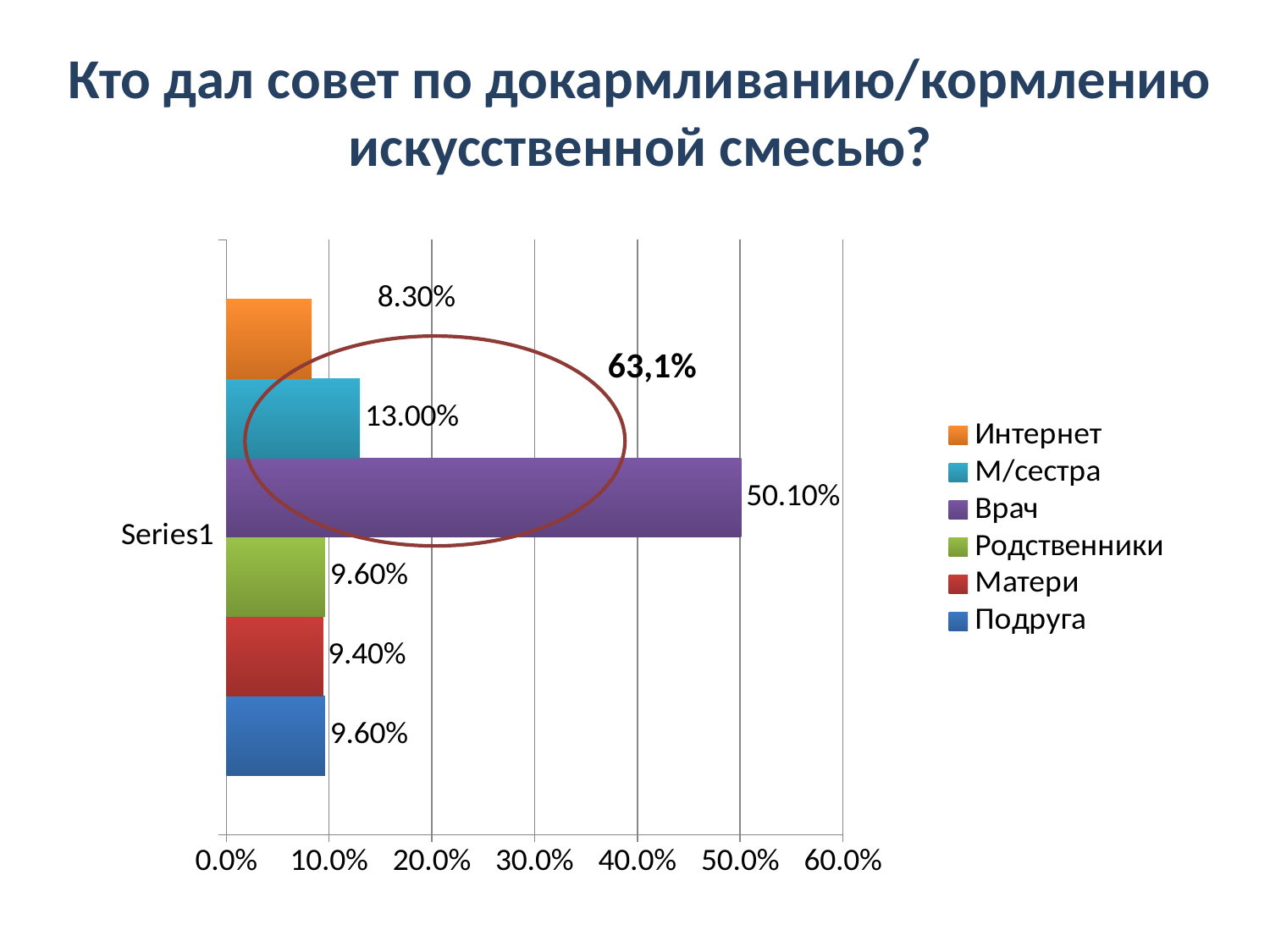
What is the difference between the values for Врач and М/сестра? 37.10% What kind of chart is shown on the slide? bar chart How many series does the legend list? 6 Which is larger, the value for М/сестра or the value for Родственники? М/сестра What is the value for М/сестра? 13.00% What is the title of the chart on the slide? Кто дал совет по докармливанию/кормлению искусственной смесью? What is the value for Матери? 9.40% Is the value for Врач greater or less than 40.0%? greater What is the value for Врач? 50.10% What is the value for Интернет? 8.30% Which category has the lowest value? Интернет Which category has the highest value? Врач